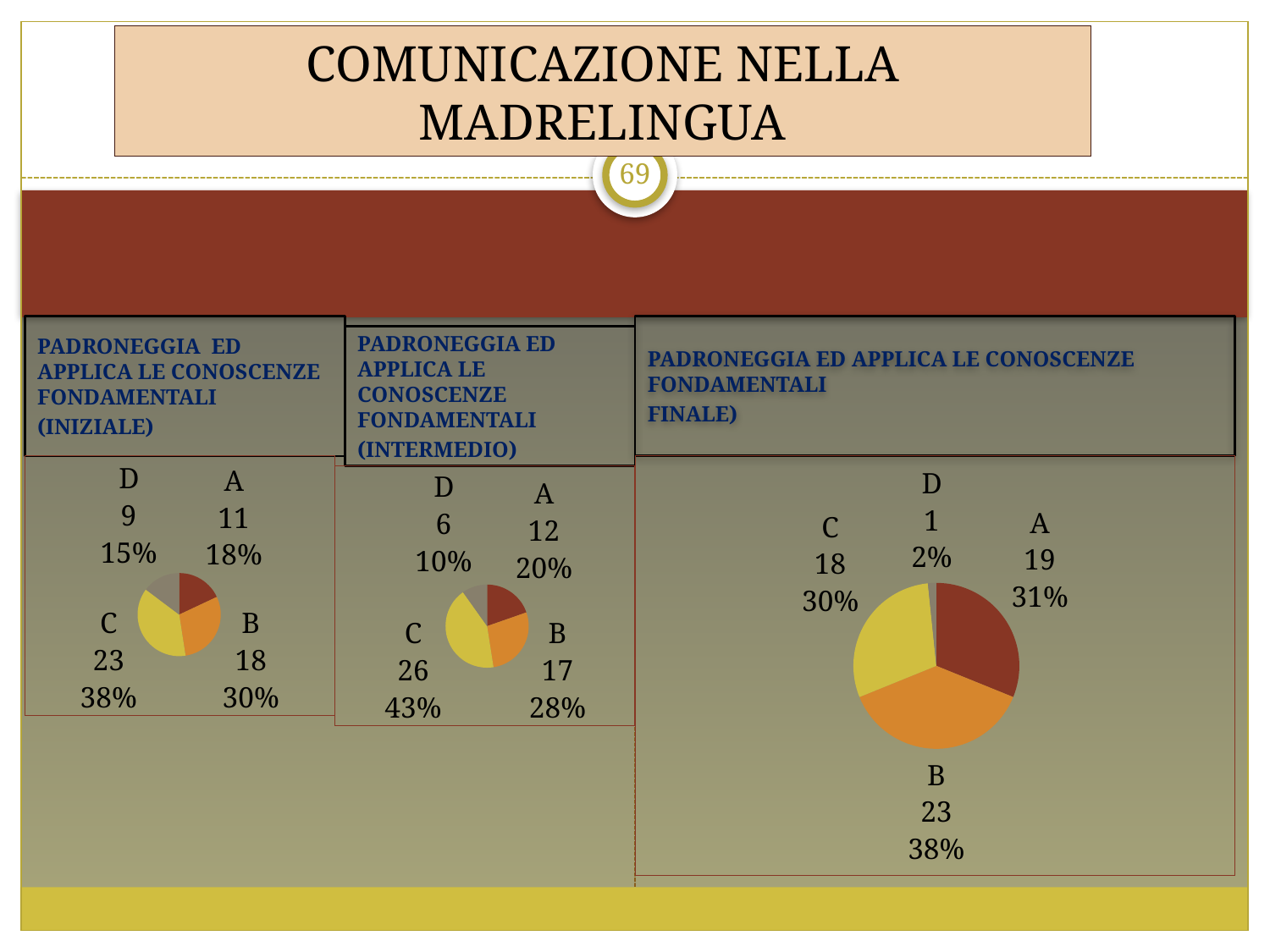
In the INTERMEDIO pie chart, which category has the highest value? C In the INIZIALE pie chart, which category has the lowest value? D In the INIZIALE pie chart, what percentage share does category B have? 30% In the FINALE pie chart, what is the value for category B? 23 In the INTERMEDIO pie chart, what is the value for category A? 12 What type of chart is used on this slide? Pie chart In the FINALE pie chart, which category has the lowest value? D In the INTERMEDIO pie chart, what percentage share does category D have? 10% In the INTERMEDIO pie chart, what is the difference between the values for C and B? 9 In the INIZIALE pie chart, what is the value for category C? 23 In the FINALE pie chart, which is larger, the value for A or the value for C? A How many categories does the FINALE pie chart show? 4